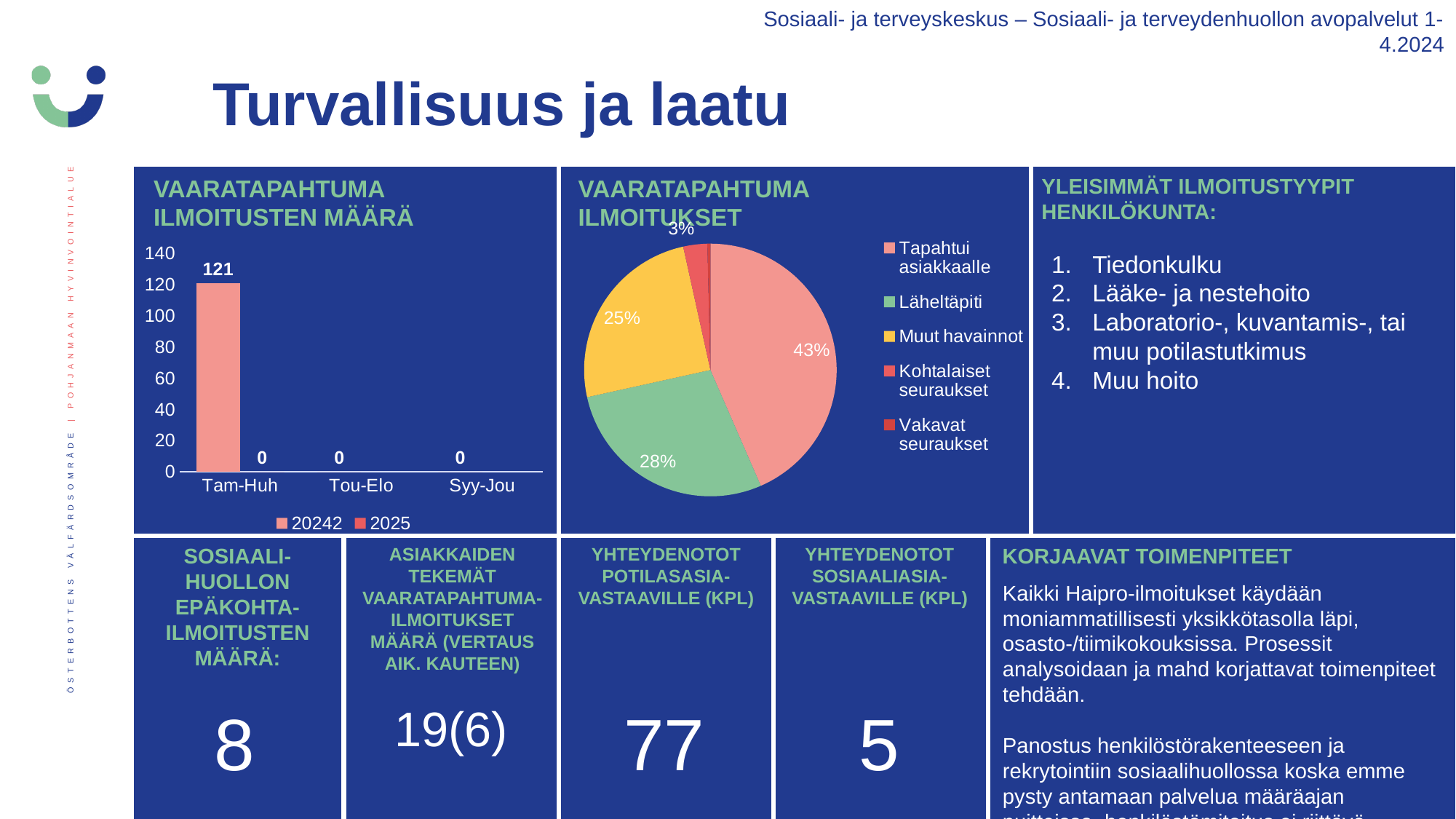
In the chart titled 'VAARATAPAHTUMA ILMOITUKSET', how many entries does the legend list? 5 In the chart titled 'VAARATAPAHTUMA ILMOITUSTEN MÄÄRÄ', how many categories are on the x axis? 3 In the chart titled 'VAARATAPAHTUMA ILMOITUSTEN MÄÄRÄ', what kind of chart is shown? bar chart In the chart titled 'VAARATAPAHTUMA ILMOITUKSET', what share of the pie is 'Tapahtui asiakkaalle'? 43% In the chart titled 'VAARATAPAHTUMA ILMOITUKSET', what share of the pie is 'Muut havainnot'? 25% In the chart titled 'VAARATAPAHTUMA ILMOITUSTEN MÄÄRÄ', how many series does the legend list? 2 In the chart titled 'VAARATAPAHTUMA ILMOITUSTEN MÄÄRÄ', which category has the highest value? Tam-Huh In the chart titled 'VAARATAPAHTUMA ILMOITUKSET', what is the difference between the shares of 'Tapahtui asiakkaalle' and 'Läheltäpiti'? 15% In the chart titled 'VAARATAPAHTUMA ILMOITUSTEN MÄÄRÄ', is the value for Tam-Huh greater or less than 100? greater In the chart titled 'VAARATAPAHTUMA ILMOITUSTEN MÄÄRÄ', what is the value for Tam-Huh in the 2024 series? 121 In the chart titled 'VAARATAPAHTUMA ILMOITUKSET', what share of the pie is 'Läheltäpiti'? 28% In the chart titled 'VAARATAPAHTUMA ILMOITUKSET', which slice is the largest? Tapahtui asiakkaalle